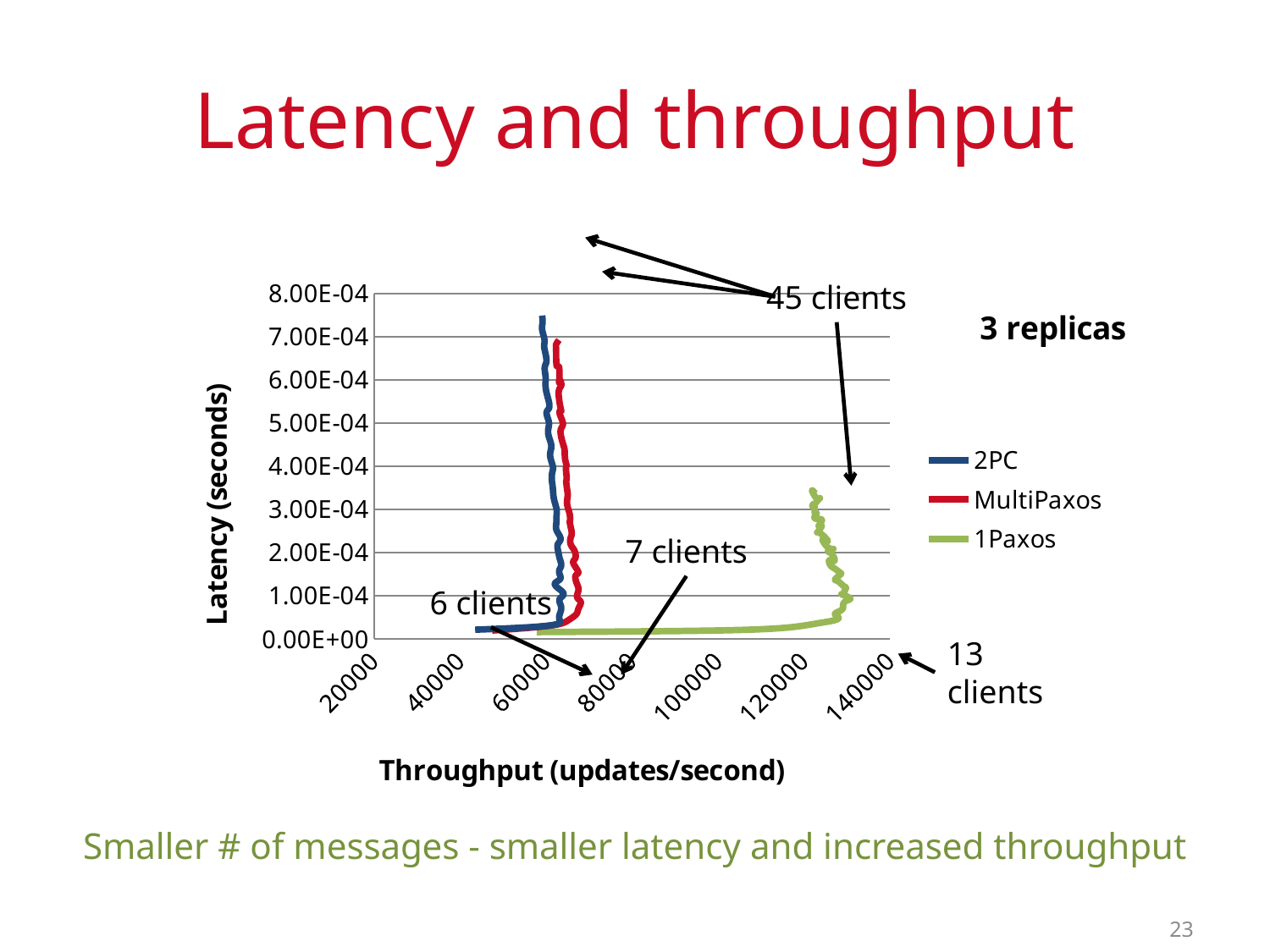
Which series reaches a higher throughput, 1Paxos or MultiPaxos? 1Paxos What is the label of the vertical axis of the chart? Latency (seconds) Which series reaches the highest throughput on the chart? 1Paxos Which series has the lowest maximum latency on the chart? 1Paxos What kind of chart is shown on the slide? line chart Is the maximum latency reached by 2PC greater or less than 7.00E-04 seconds? greater How many series does the chart's legend list? 3 What is the title of the chart on the slide? 3 replicas Is the maximum throughput reached by 1Paxos greater or less than 120000 updates/second? greater Is the maximum throughput reached by 2PC greater or less than 80000 updates/second? less Which series reaches a higher throughput, MultiPaxos or 2PC? MultiPaxos